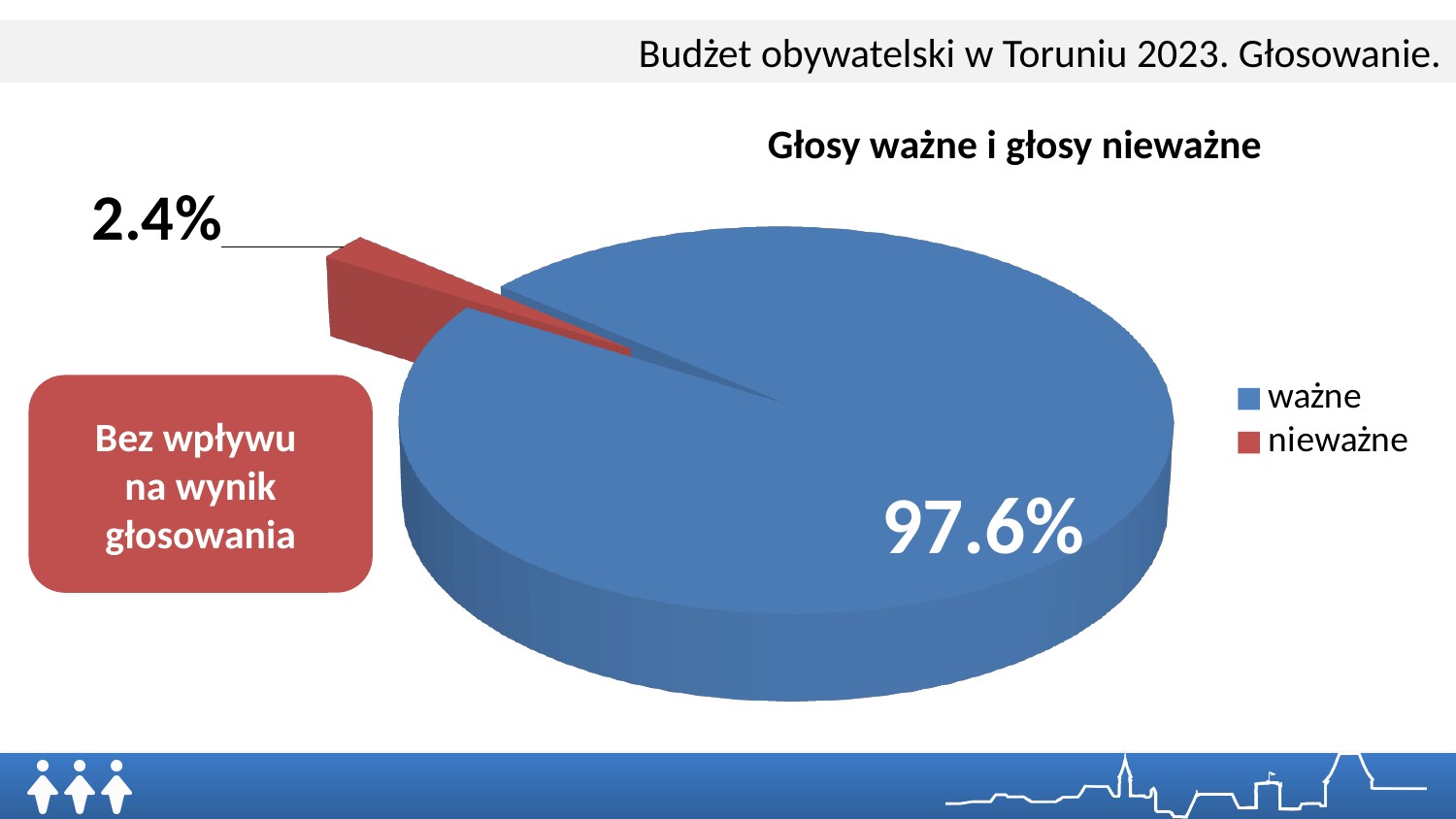
Which category has the largest slice of the pie? ważne Which category has the smallest slice of the pie? nieważne How many slices does the pie chart have? 2 What colour is the 'nieważne' slice? red What share of the pie is labelled 'nieważne'? 2.4% What kind of chart is shown on the slide? pie chart What is the chart's title? Głosy ważne i głosy nieważne What share of the pie is labelled 'ważne'? 97.6% How many categories does the legend list? 2 What is the difference in percentage points between the 'ważne' and 'nieważne' slices? 95.2 Which slice is larger, 'ważne' or 'nieważne'? ważne